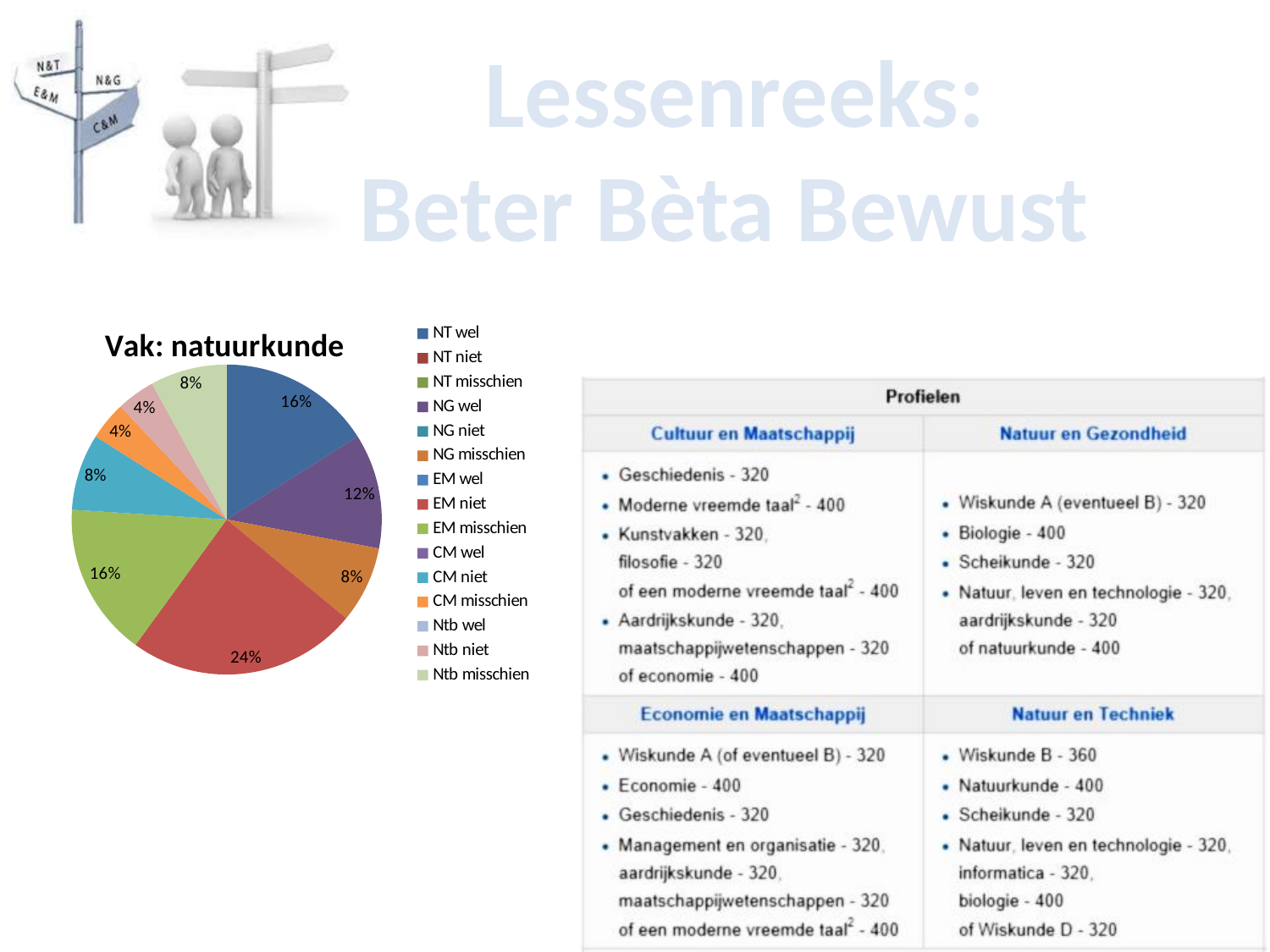
What kind of chart is shown on the slide? pie chart How many slices in the pie chart are labelled 8%? 3 How many slices in the pie chart are labelled 16%? 2 How many entries does the legend of the pie chart list? 15 How many slices does the pie chart have? 9 What share of the pie does the dark blue slice for NT wel represent? 16% Which legend entry is listed first in the pie chart's legend? NT wel What is the difference between the largest slice (24%) and a smallest slice (4%) in the pie chart? 20% What is the percentage of the largest slice in the pie chart? 24% What is the percentage of the smallest slices in the pie chart? 4% What is the title of the pie chart? Vak: natuurkunde Which is larger in the pie chart: the red slice or the purple slice? the red slice